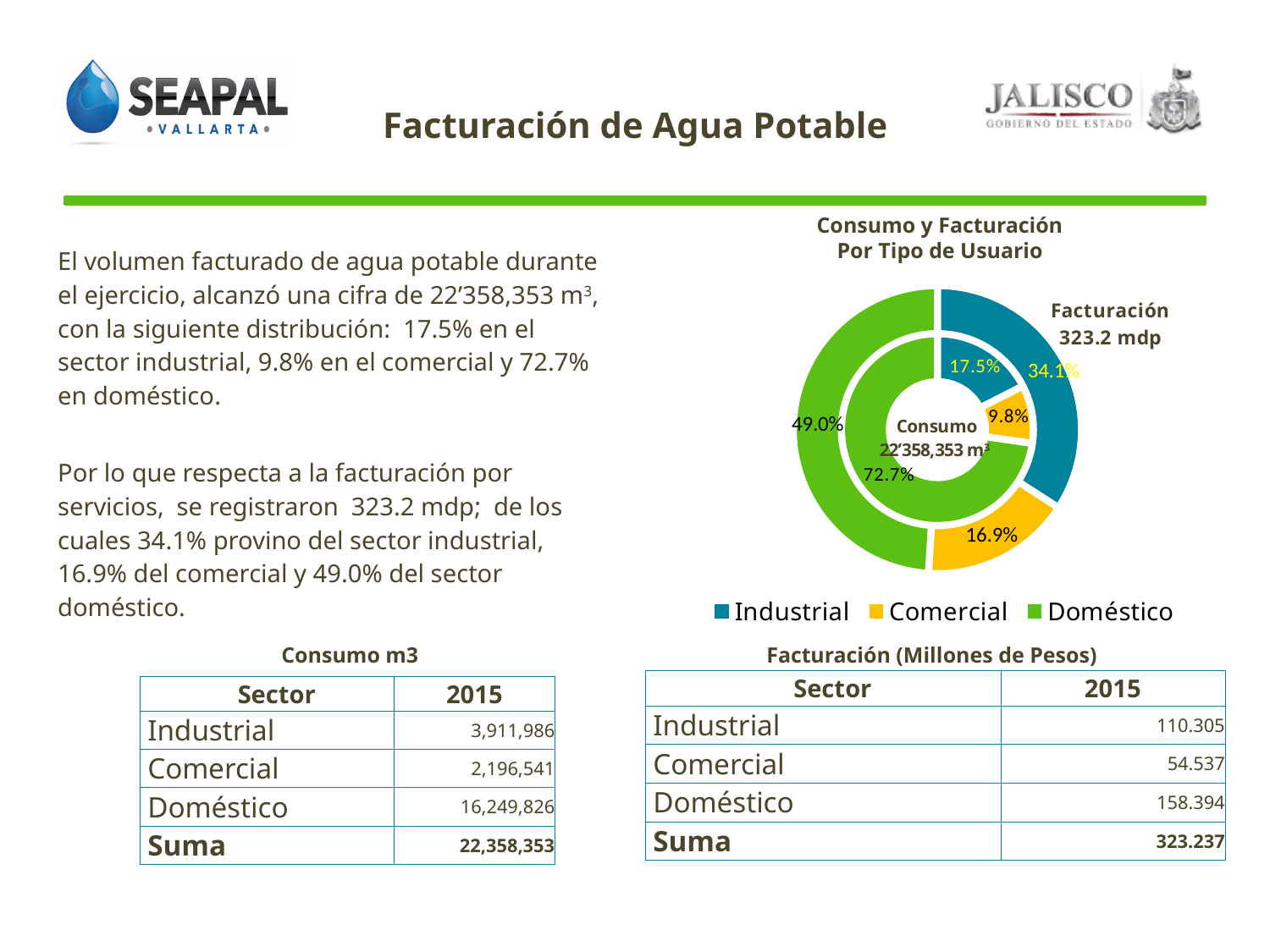
In the doughnut chart, which sector has the smallest share of Facturación? Comercial How many sectors does the legend of the doughnut chart list? 3 In the doughnut chart, what share of Consumo does the Industrial sector represent? 17.5% In the doughnut chart, which sector has the largest share of Consumo? Doméstico In the doughnut chart, what share of Facturación comes from the Comercial sector? 16.9% In the doughnut chart, what share of Consumo does the Doméstico sector represent? 72.7% In the doughnut chart, what total Facturación amount is shown next to the outer ring? 323.2 mdp What type of chart is shown under the title "Consumo y Facturación Por Tipo de Usuario"? Doughnut chart In the doughnut chart, what is the difference between the Doméstico share of Consumo and the Doméstico share of Facturación? 23.7 percentage points